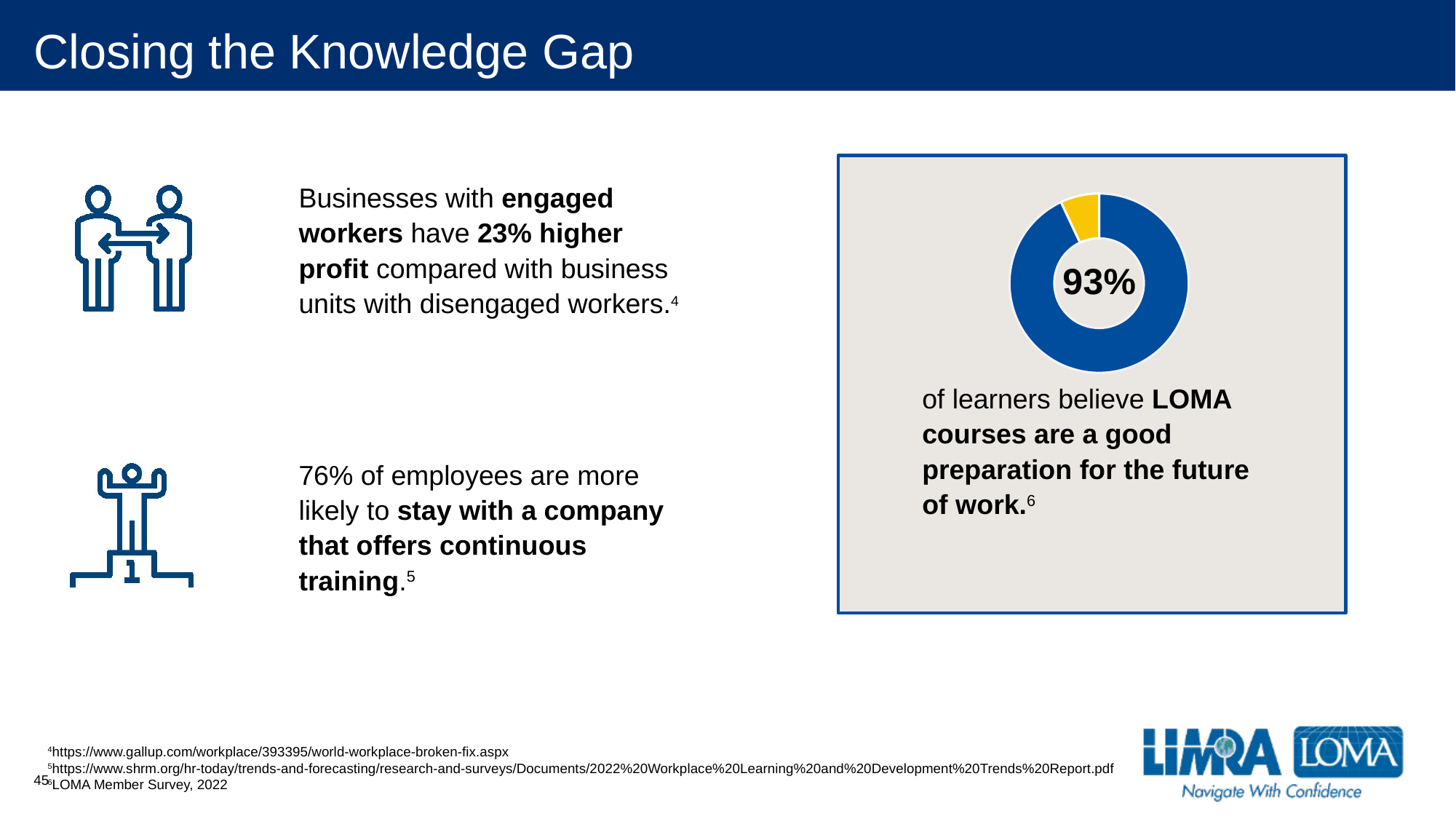
Is the yellow slice of the donut chart greater or less than 25%? less How many slices does the donut chart have? 2 What share of the donut chart does the yellow slice represent? 7% Is the blue slice of the donut chart greater or less than 50%? greater Which slice of the donut chart is larger, the blue one or the yellow one? blue What kind of chart is shown on the right side of the slide? donut chart According to the text under the donut chart, what does the 93% represent? learners who believe LOMA courses are a good preparation for the future of work What percentage is printed in the centre of the donut chart? 93% What colour is the largest slice of the donut chart? blue